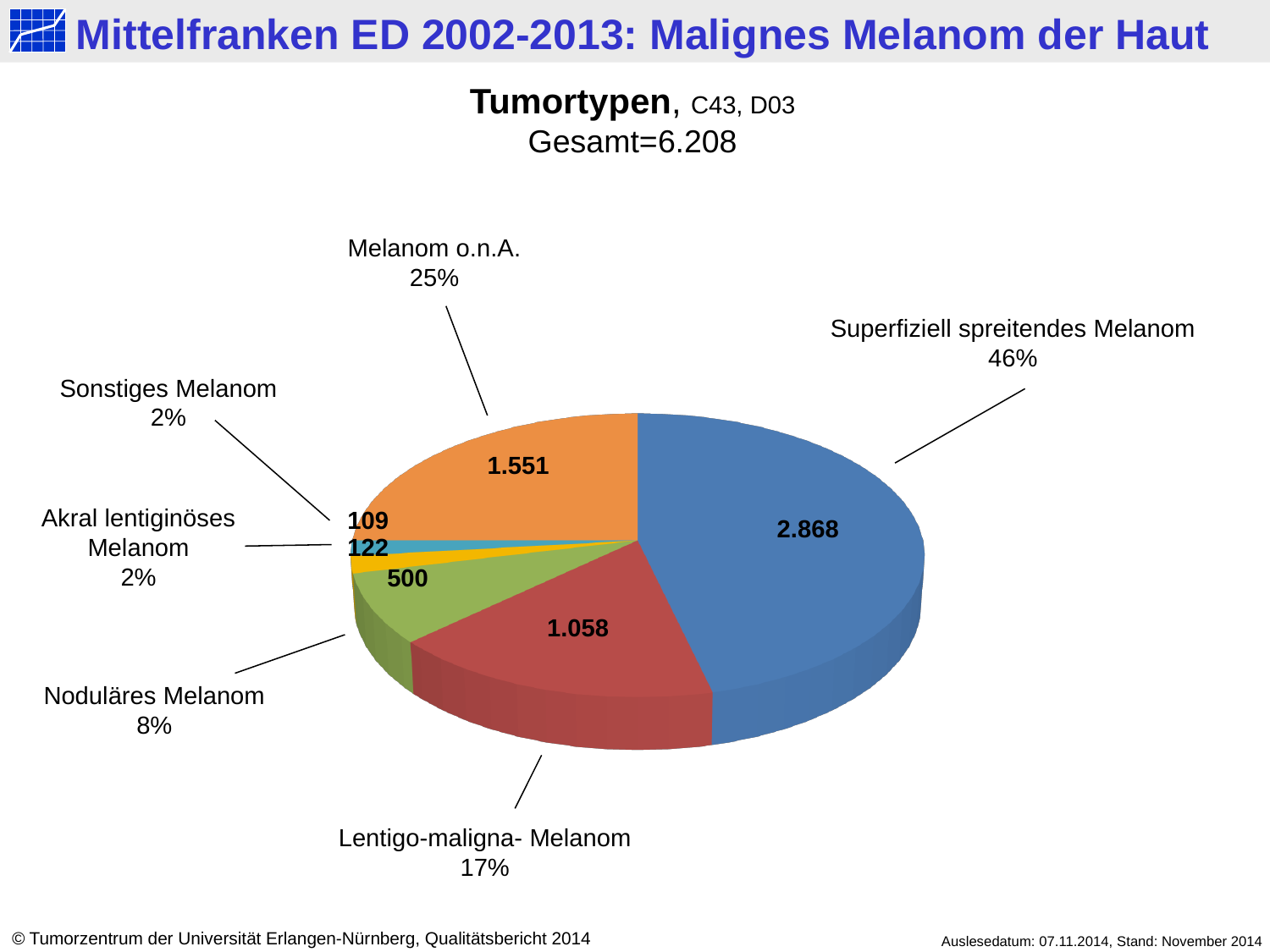
Which is larger, the value for Melanom o.n.A. or the value for Lentigo-maligna- Melanom? Melanom o.n.A. What share of the pie does Superfiziell spreitendes Melanom account for? 46% What is the value shown for Noduläres Melanom? 500 What share of the pie does Lentigo-maligna- Melanom account for? 17% What is the difference between the values for Superfiziell spreitendes Melanom and Melanom o.n.A.? 1.317 What share of the pie does Noduläres Melanom account for? 8% How many tumour type categories are shown in the pie chart? 6 What kind of chart is shown on the slide? pie chart What is the value shown for Melanom o.n.A.? 1.551 What is the value shown for Lentigo-maligna- Melanom? 1.058 What is the value shown for Superfiziell spreitendes Melanom? 2.868 Which tumour type has the largest slice in the pie chart? Superfiziell spreitendes Melanom